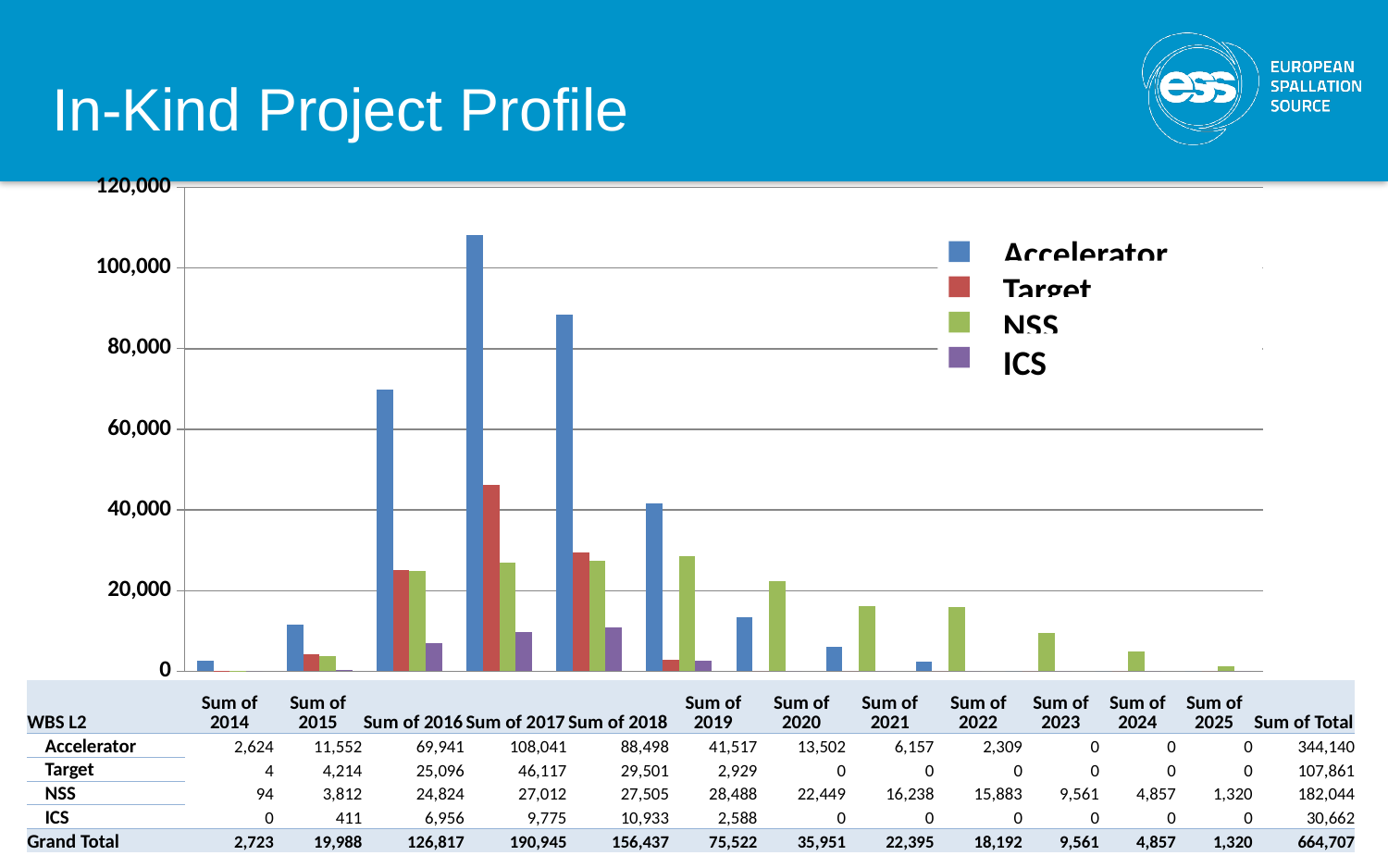
What is the Accelerator value for 2017? 108,041 What is the NSS value for 2019? 28,488 What is the ICS value for 2018? 10,933 What is the Grand Total for 2017? 190,945 How many series does the legend list? 4 What is the difference between the Accelerator and Target values in 2017? 61,924 How many years are plotted along the x axis? 12 Is the Accelerator value for 2016 greater or less than 60,000? greater Do the NSS values rise or fall from 2019 to 2025? fall What kind of chart is shown on the slide? bar chart In which year is the Accelerator value highest? 2017 Which is larger in 2018, the Accelerator value or the Target value? Accelerator